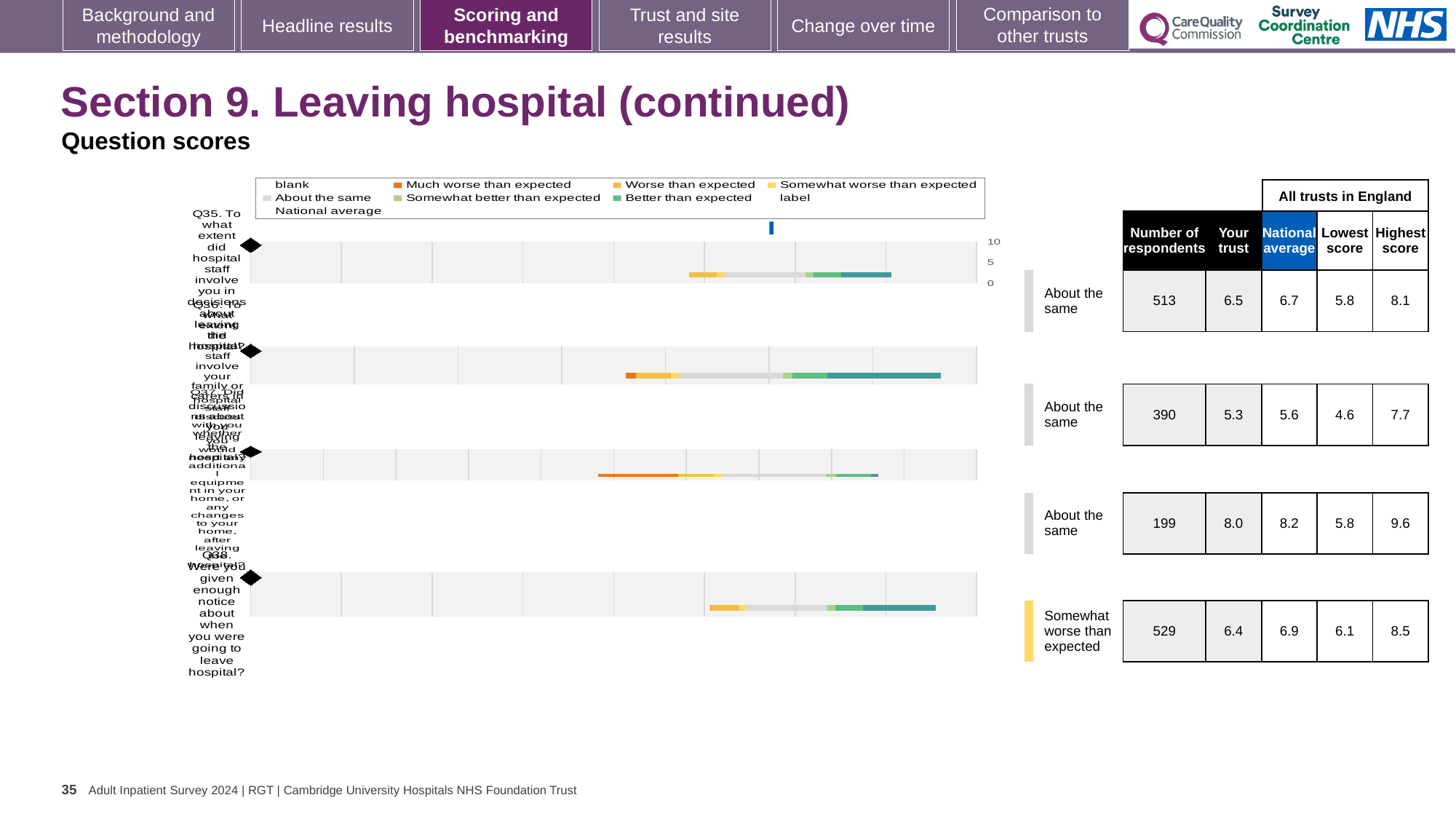
How many respondents are listed for Q37 (the third row)? 199 What is the national average score for Q35 (the top row)? 6.7 How many questions (rows) are plotted in the chart? 4 What kind of chart is used to show the question scores on this slide? bar chart Which question has the lowest 'Your trust' score? Q36 What is the highest score among all trusts in England for Q36 (the second row)? 7.7 For Q35, which is larger: the 'Your trust' score or the national average? National average For Q38, what is the difference between the national average and the 'Your trust' score? 0.5 Which question is rated 'Somewhat worse than expected'? Q38 What is the 'Your trust' score for Q38 (the bottom row, about being given enough notice about leaving hospital)? 6.4 Which question has the highest 'Your trust' score? Q37 How many of the questions are rated 'About the same'? 3